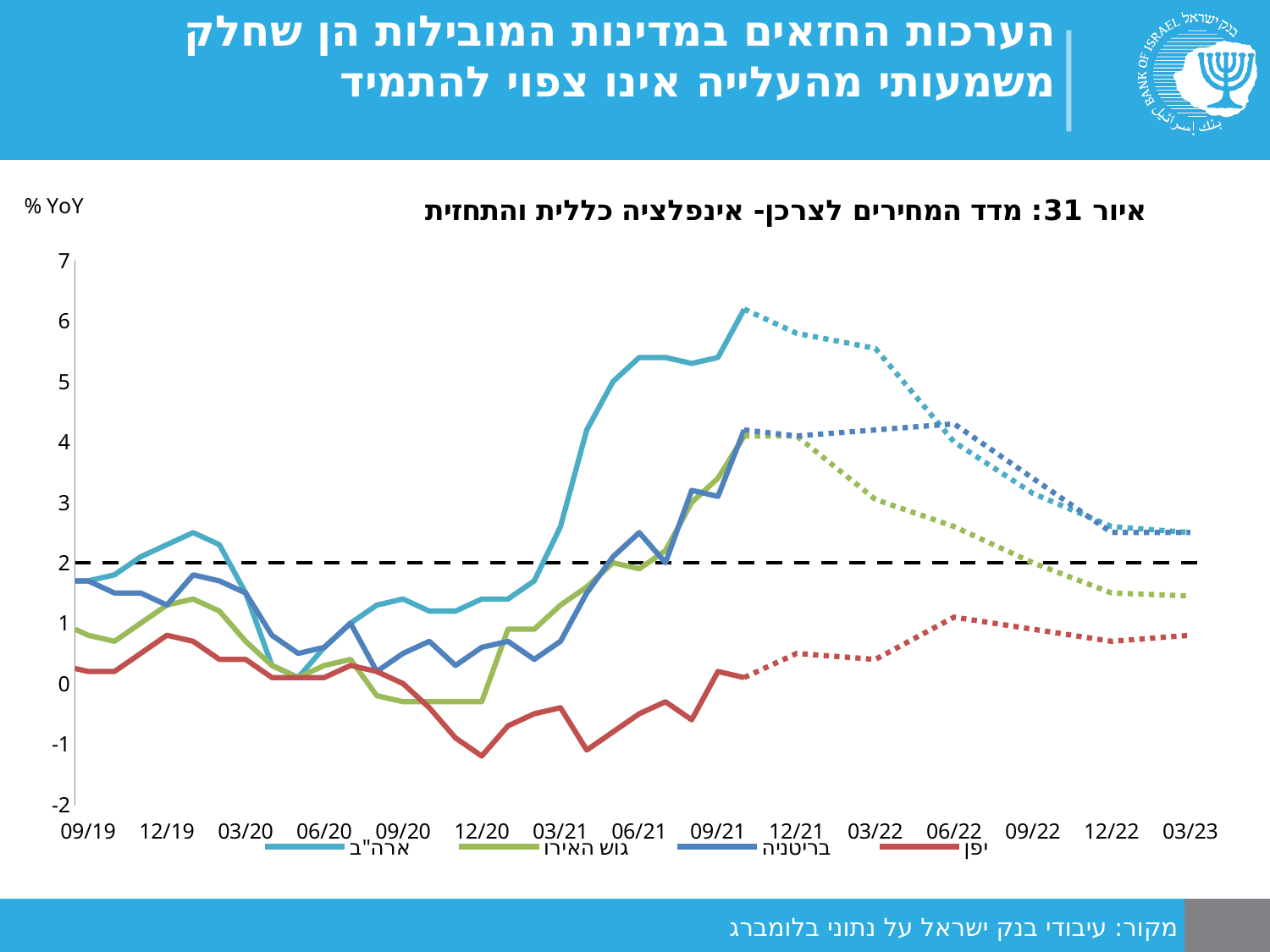
Does the ארה"ב series rise or fall between 09/21 and 03/23? fall Is the value for גוש האירו at 03/23 greater or less than 2? less Which series are listed in the legend? ארה"ב, גוש האירו, בריטניה, יפן How many series does the legend list? 4 Which series reaches the highest value on the chart? ארה"ב Which series reaches the lowest value on the chart? יפן At what level is the dashed horizontal line drawn on the chart? 2 Is the value for ארה"ב at 09/21 greater or less than 5? greater At 03/22, which series has the larger value, ארה"ב or יפן? ארה"ב What kind of chart is shown on the slide? line chart Is the value for יפן at 12/20 greater or less than 0? less